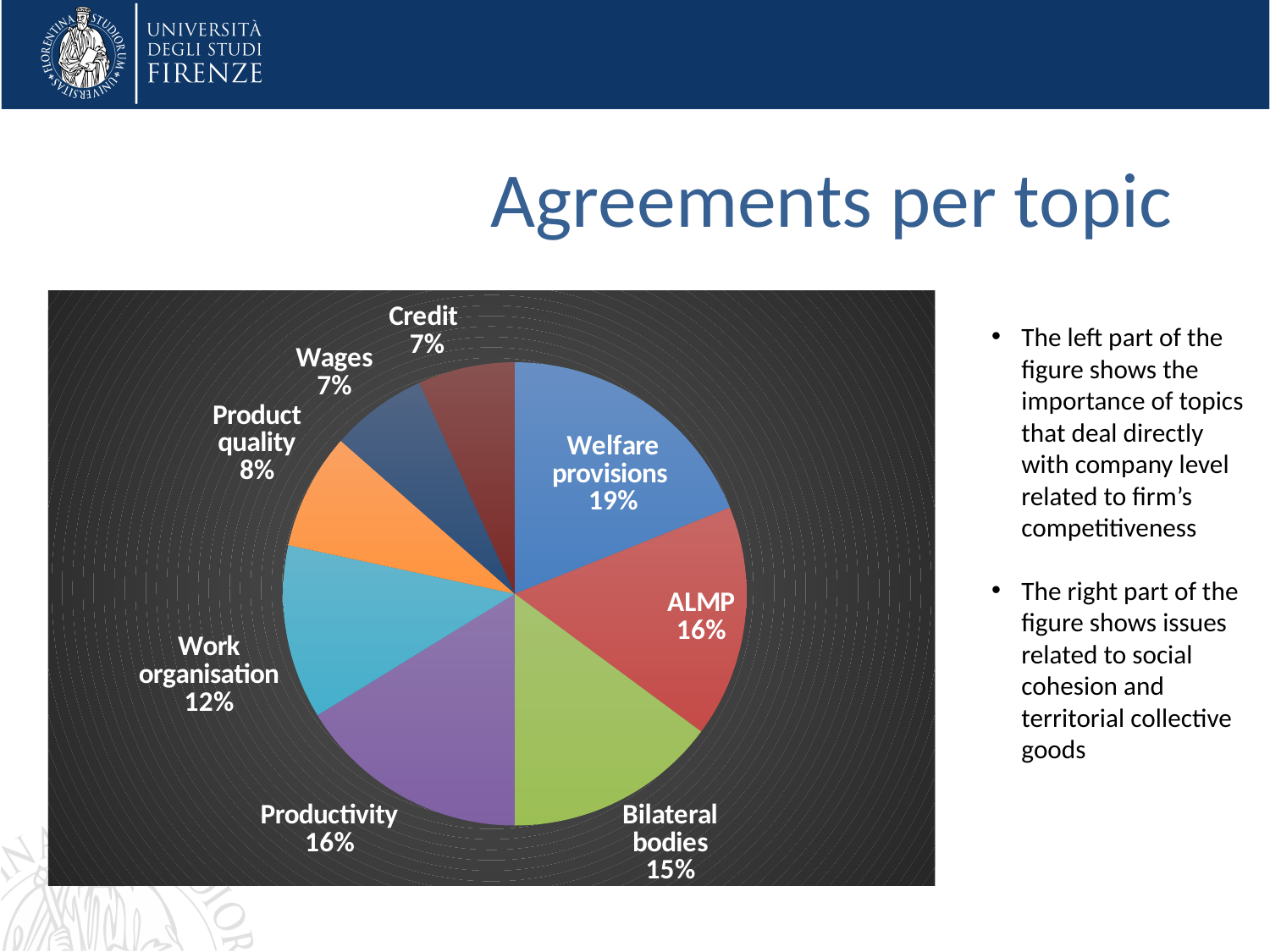
How many topics (slices) does the pie chart show? 8 Which has a larger share, Work organisation or Product quality? Work organisation What is the title of the slide containing the pie chart? Agreements per topic What percentage is shown for Work organisation? 12% What is the difference in percentage points between Productivity and Work organisation? 4 What kind of chart is shown on the slide? Pie chart Which has a larger share, ALMP or Bilateral bodies? ALMP What is the difference in percentage points between Welfare provisions and Credit? 12 What share of agreements is for Welfare provisions? 19% What percentage is shown for Product quality? 8% What percentage is shown for Bilateral bodies? 15% Which topic has the largest share of agreements? Welfare provisions